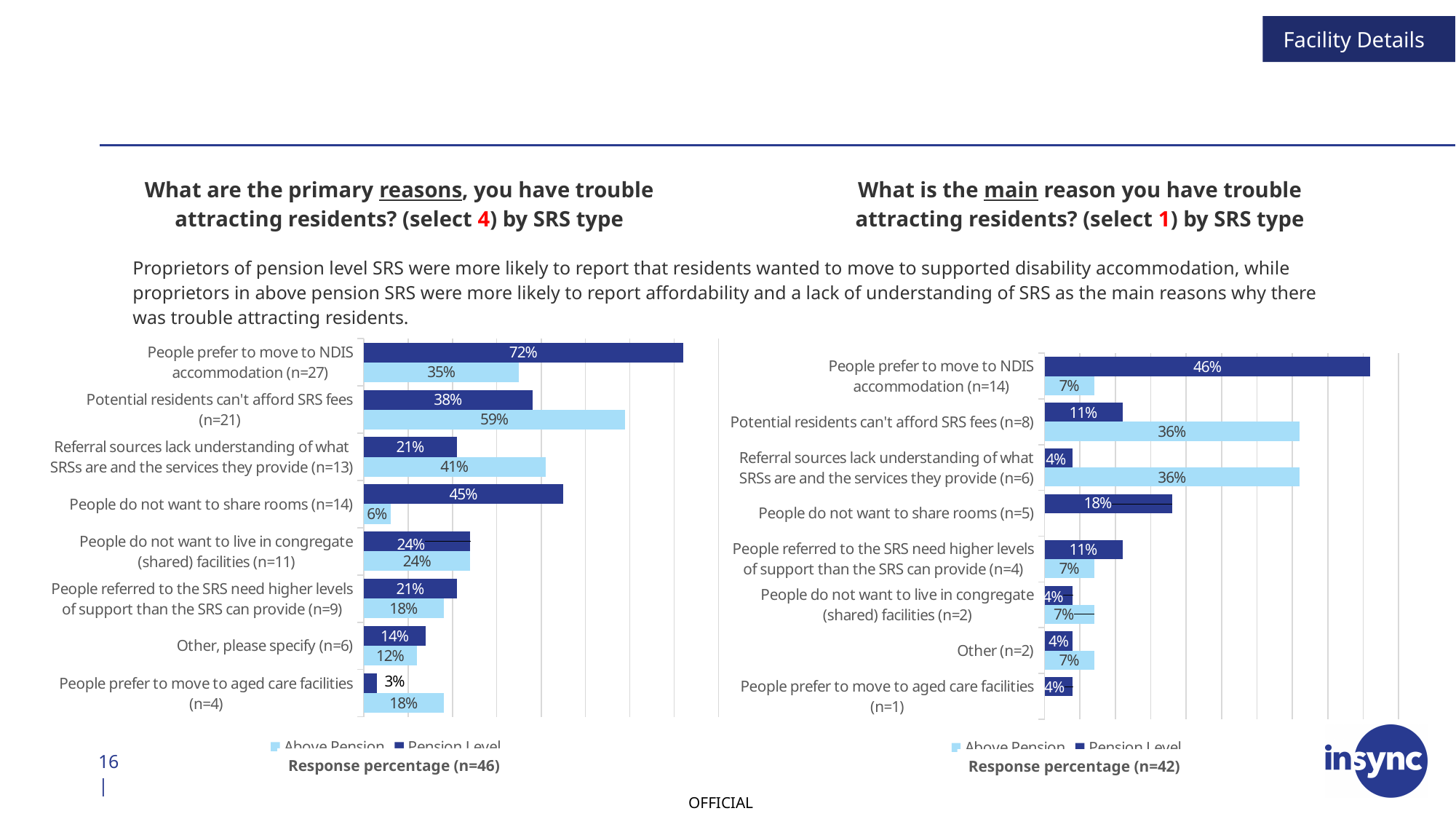
In the left chart (primary reasons, select 4), what is the difference between the Pension Level and Above Pension values for 'People do not want to share rooms'? 39 percentage points In the right chart (main reason, select 1), what is the Above Pension value for 'Potential residents can't afford SRS fees'? 36% In the left chart (primary reasons, select 4), which category has the highest Pension Level value? People prefer to move to NDIS accommodation What type of chart is the left chart (primary reasons, select 4)? Bar chart How many series does the legend of the left chart (primary reasons, select 4) list? 2 In the left chart (primary reasons, select 4), what is the Pension Level value for 'People prefer to move to NDIS accommodation'? 72% In the left chart (primary reasons, select 4), what is the Above Pension value for 'Potential residents can't afford SRS fees'? 59% In the left chart (primary reasons, select 4), which is larger for 'Referral sources lack understanding of what SRSs are and the services they provide': Above Pension or Pension Level? Above Pension In the left chart (primary reasons, select 4), which category has the lowest Above Pension value? People do not want to share rooms In the right chart (main reason, select 1), what is the Pension Level value for 'People prefer to move to NDIS accommodation'? 46% In the right chart (main reason, select 1), what is the difference between the Above Pension and Pension Level values for 'Referral sources lack understanding of what SRSs are and the services they provide'? 32 percentage points How many categories are shown in the right chart (main reason, select 1)? 8